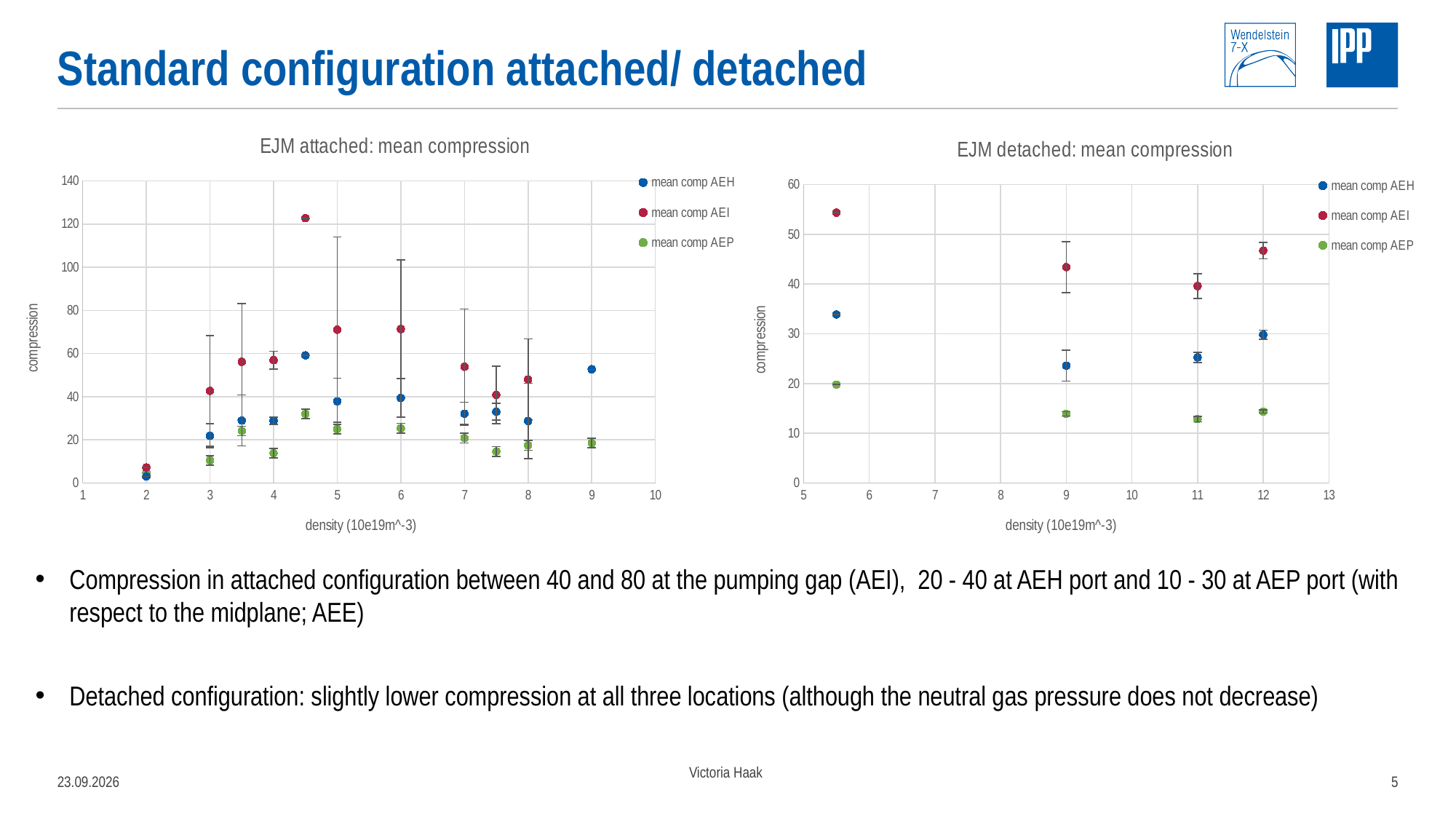
How many series does the legend of the 'EJM detached: mean compression' chart list? 3 In the 'EJM detached: mean compression' chart, which series has the highest values at every density? mean comp AEI In the 'EJM detached: mean compression' chart, is the mean comp AEI value at density 5.5 greater or less than 50? greater How many series does the legend of the 'EJM attached: mean compression' chart list? 3 What is the x-axis label of the 'EJM detached: mean compression' chart? density (10e19m^-3) In the 'EJM attached: mean compression' chart, is the mean comp AEI value at density 4.5 greater or less than 100? greater In the 'EJM detached: mean compression' chart, is the mean comp AEP value at density 9 greater or less than 20? less What kind of chart is the 'EJM attached: mean compression' chart? scatter chart In the 'EJM detached: mean compression' chart, how many data points are plotted for the mean comp AEH series? 4 In the 'EJM attached: mean compression' chart, at which density is the mean comp AEI value highest? 4.5 In the 'EJM detached: mean compression' chart, at density 12, which is larger: mean comp AEH or mean comp AEP? mean comp AEH